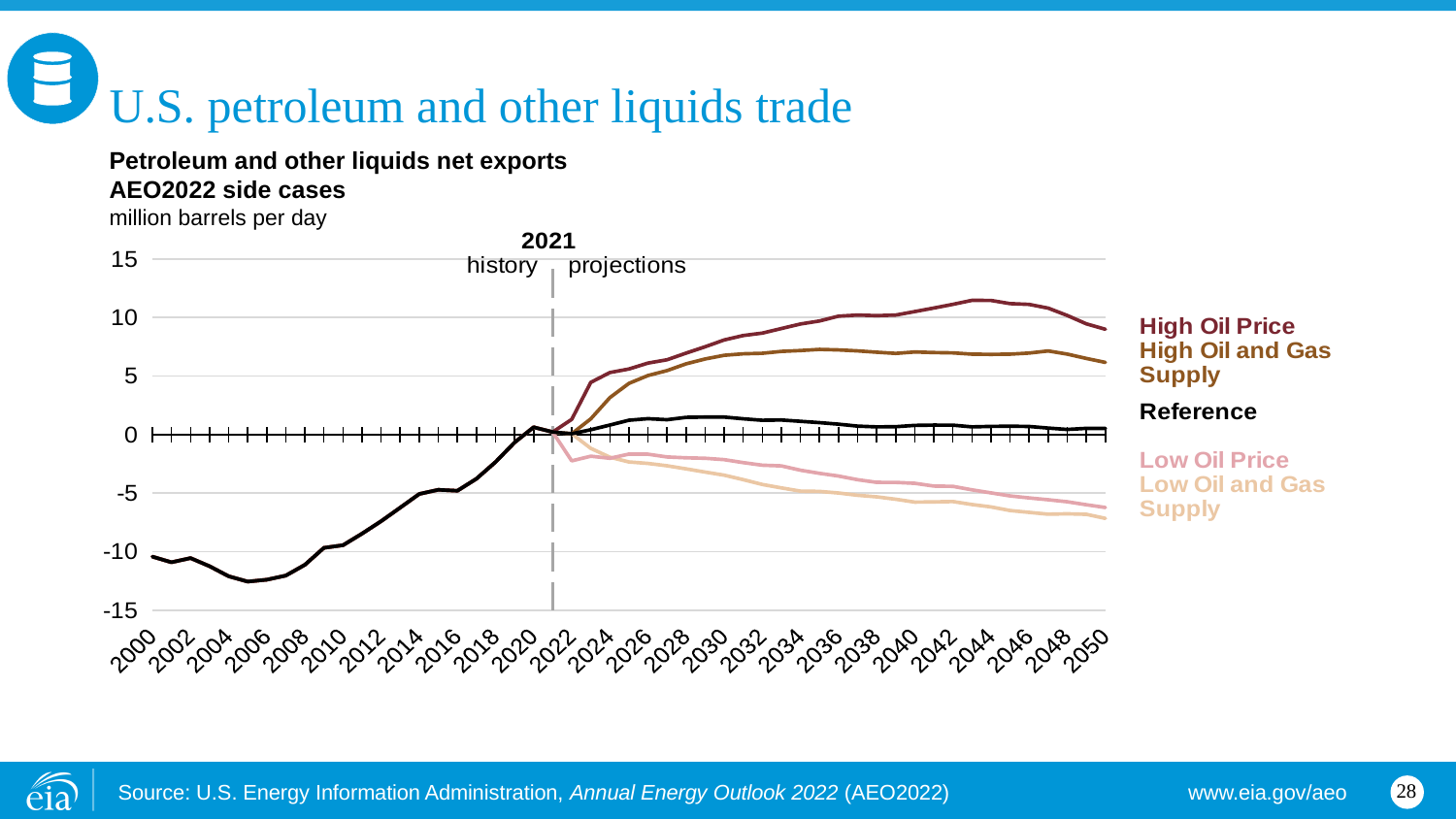
Is the value for Low Oil and Gas Supply in 2050 greater or less than -5? less Do the historical net exports rise or fall between 2006 and 2020? rise What unit is the y axis measured in? million barrels per day In 2050, which is larger: High Oil Price or High Oil and Gas Supply? High Oil Price Which series has the highest value in 2050? High Oil Price How many series (side cases) does the legend list? 5 Is the historical value in 2005 greater or less than -10? less Is the value for High Oil Price in 2050 greater or less than 5? greater What kind of chart is shown on the slide? line chart Which year marks the boundary between history and projections? 2021 Which series has the lowest value in 2050? Low Oil and Gas Supply